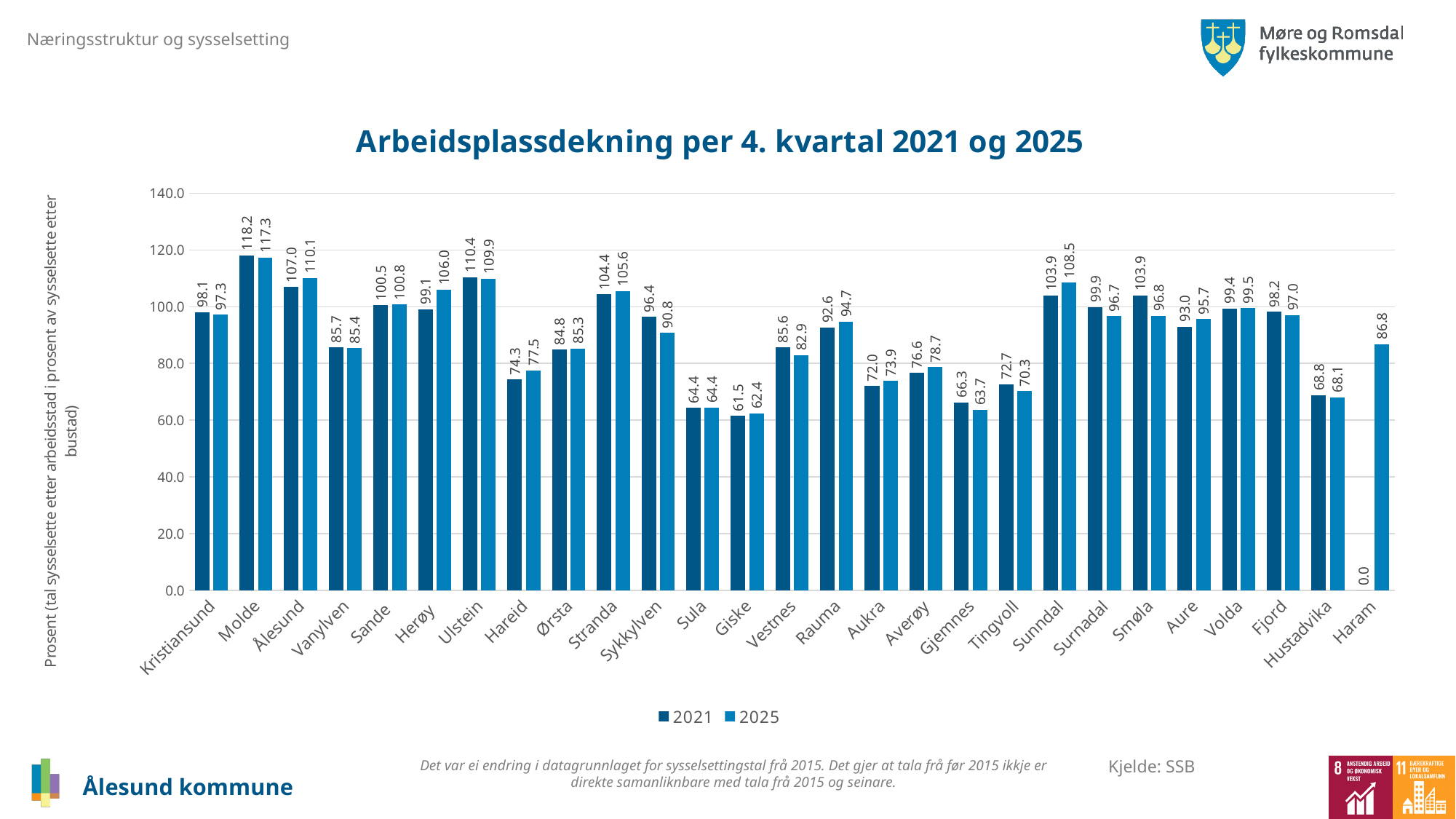
What is the 2025 value for Haram? 86.8 How many series does the legend list? 2 Is the 2021 value for Smøla greater or less than 100.0? greater Which municipality has the lowest 2025 value? Giske Which is larger for Sunndal, the 2021 value or the 2025 value? 2025 What is the 2021 value for Sykkylven? 96.4 What is the title of the chart? Arbeidsplassdekning per 4. kvartal 2021 og 2025 What is the difference between the 2025 and 2021 values for Herøy? 6.9 What is the 2025 value for Ålesund? 110.1 What kind of chart is shown on the slide? Bar chart How many municipalities are shown on the x axis? 27 Which municipality has the highest 2021 value? Molde